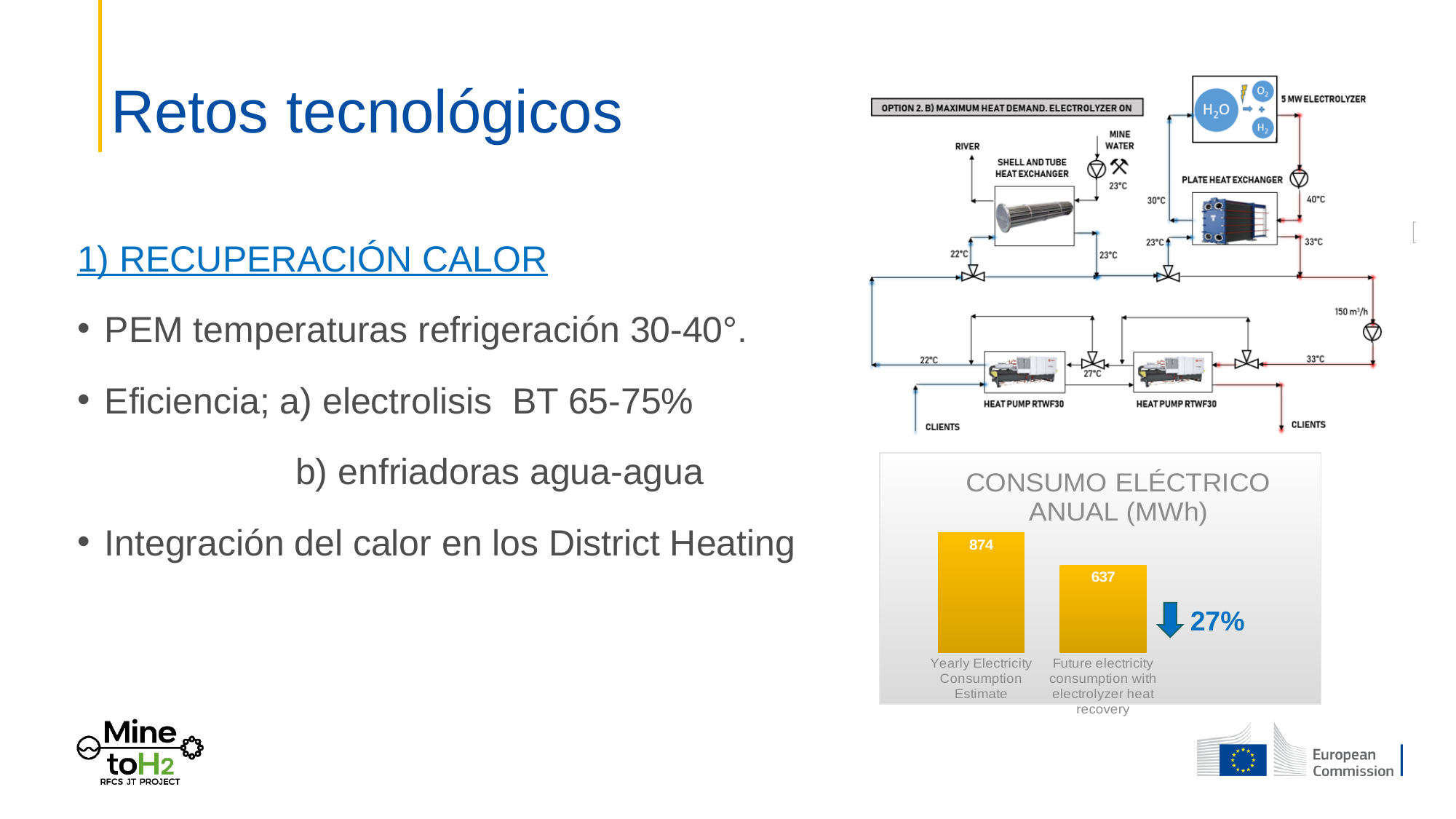
What is the title of the chart on the slide? CONSUMO ELÉCTRICO ANUAL (MWh) Which category has the highest value in the CONSUMO ELÉCTRICO ANUAL (MWh) chart? Yearly Electricity Consumption Estimate What kind of chart is the CONSUMO ELÉCTRICO ANUAL (MWh) chart? Bar chart How many bars are shown in the CONSUMO ELÉCTRICO ANUAL (MWh) chart? 2 What percentage reduction is annotated next to the bars in the CONSUMO ELÉCTRICO ANUAL (MWh) chart? 27% Do the values fall or rise from the first bar to the second bar in the CONSUMO ELÉCTRICO ANUAL (MWh) chart? Fall What is the value for Future electricity consumption with electrolyzer heat recovery in the CONSUMO ELÉCTRICO ANUAL (MWh) chart? 637 What is the value for Yearly Electricity Consumption Estimate in the CONSUMO ELÉCTRICO ANUAL (MWh) chart? 874 What is the difference between the Yearly Electricity Consumption Estimate and the Future electricity consumption with electrolyzer heat recovery in the CONSUMO ELÉCTRICO ANUAL (MWh) chart? 237 Which category has the lowest value in the CONSUMO ELÉCTRICO ANUAL (MWh) chart? Future electricity consumption with electrolyzer heat recovery In the CONSUMO ELÉCTRICO ANUAL (MWh) chart, which is larger: Yearly Electricity Consumption Estimate or Future electricity consumption with electrolyzer heat recovery? Yearly Electricity Consumption Estimate